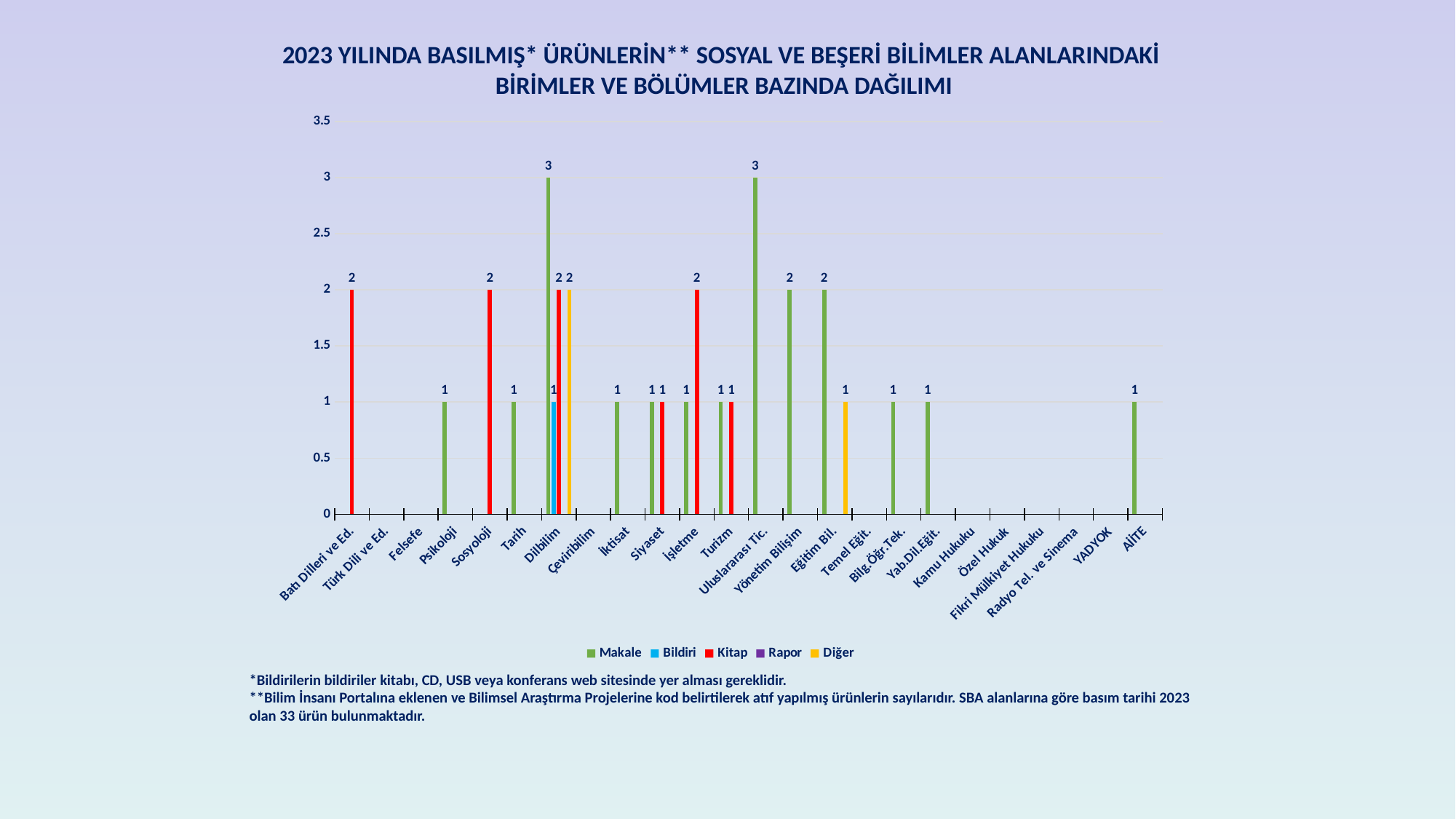
What is the Kitap value for Batı Dilleri ve Ed.? 2 Which series is shown in red in the legend? Kitap What is the Diğer value for Eğitim Bil.? 1 What is the difference between the Makale value for Dilbilim and the Makale value for Yönetim Bilişim? 1 What is the Makale value for Uluslararası Tic.? 3 What type of chart is shown on the slide? bar chart What is the Kitap value for İşletme? 2 Which series is shown in yellow in the legend? Diğer What is the Bildiri value for Dilbilim? 1 What is the Makale value for Dilbilim? 3 Which is larger: the Kitap value for Sosyoloji or the Kitap value for Siyaset? Sosyoloji How many series does the legend list? 5